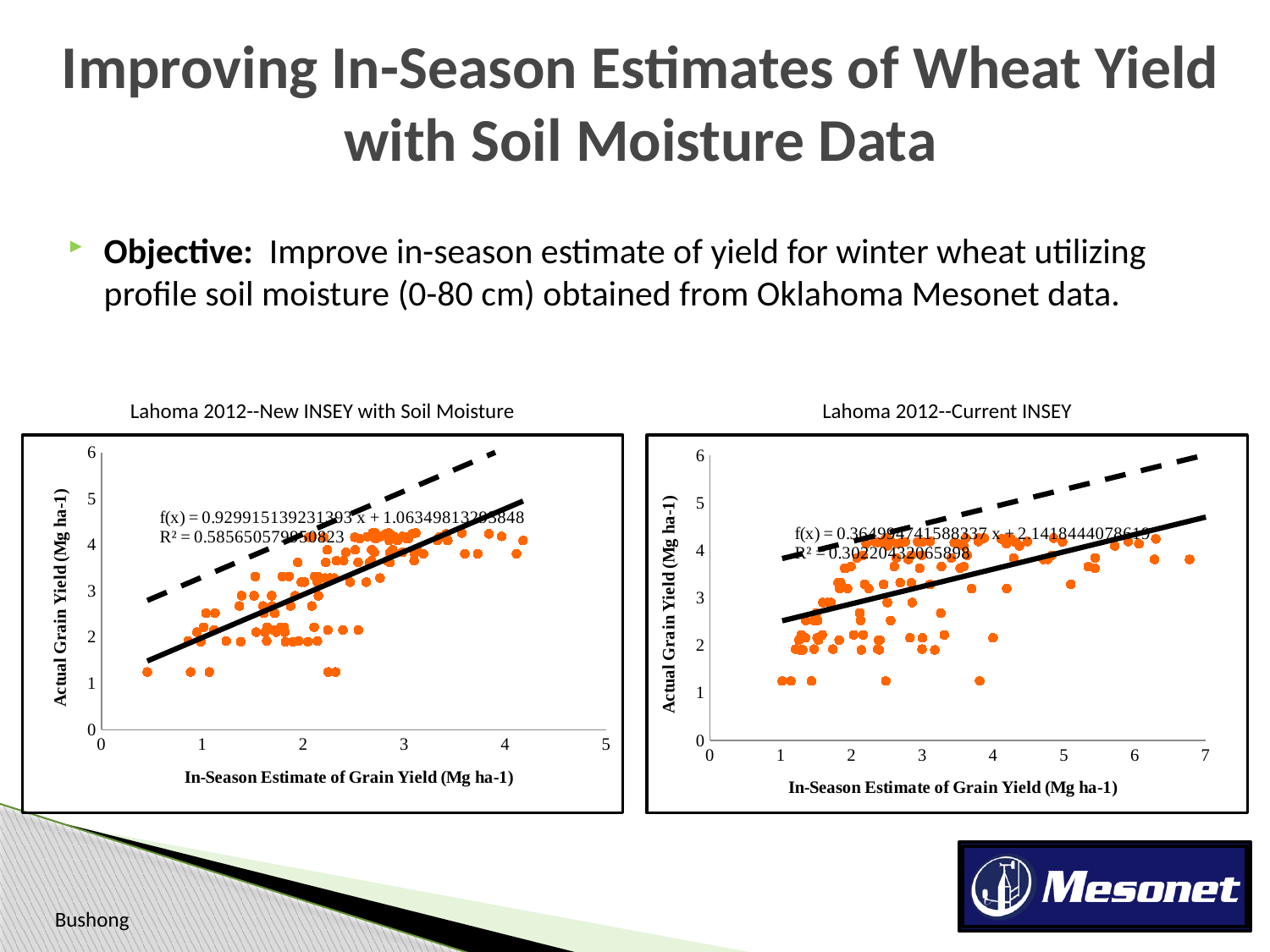
In the 'Lahoma 2012--Current INSEY' chart, does the fitted trend line rise or fall along the x axis? rise In the 'Lahoma 2012--New INSEY with Soil Moisture' chart, what is the highest value shown on the y axis? 6 In the 'Lahoma 2012--Current INSEY' chart, what is the highest value shown on the x axis? 7 What is the y-axis title of the 'Lahoma 2012--Current INSEY' chart? Actual Grain Yield (Mg ha-1) In the 'Lahoma 2012--New INSEY with Soil Moisture' chart, is the slope of the fitted line f(x) greater or less than 0.5? greater What kind of chart is the 'Lahoma 2012--New INSEY with Soil Moisture' chart? scatter plot In the 'Lahoma 2012--Current INSEY' chart, is the R² value greater or less than 0.5? less What is the title of the chart on the left of the slide? Lahoma 2012--New INSEY with Soil Moisture What kind of chart is the 'Lahoma 2012--Current INSEY' chart? scatter plot In the 'Lahoma 2012--New INSEY with Soil Moisture' chart, do the plotted points generally rise or fall as the in-season estimate increases? rise In the 'Lahoma 2012--New INSEY with Soil Moisture' chart, what is the highest value shown on the x axis? 5 Which chart reports the higher R² value, 'Lahoma 2012--New INSEY with Soil Moisture' or 'Lahoma 2012--Current INSEY'? Lahoma 2012--New INSEY with Soil Moisture